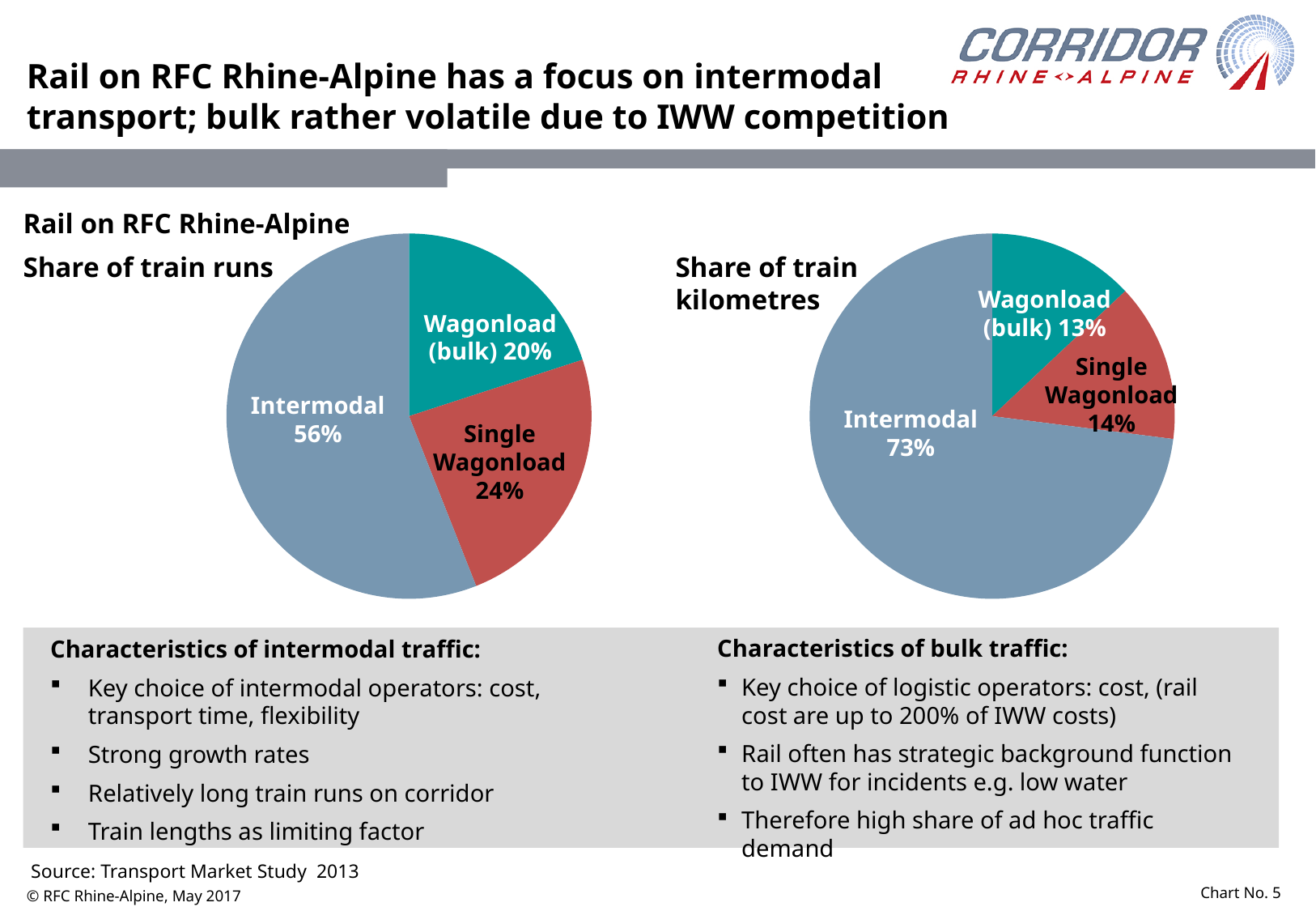
What is the difference between the Intermodal share in the 'Share of train kilometres' chart and the Intermodal share in the 'Share of train runs' chart? 17 percentage points How many slices does the 'Share of train runs' pie chart have? 3 In the 'Share of train kilometres' pie chart, which category has the smallest share? Wagonload (bulk) In the 'Share of train runs' pie chart, which category has the largest share? Intermodal In the 'Share of train runs' pie chart, what is the share for Wagonload (bulk)? 20% In the 'Share of train runs' pie chart, what is the share for Intermodal? 56% In the 'Share of train kilometres' pie chart, what is the share for Single Wagonload? 14% In the 'Share of train kilometres' pie chart, which is larger: Single Wagonload or Wagonload (bulk)? Single Wagonload In the 'Share of train runs' pie chart, what is the difference between the Single Wagonload share and the Wagonload (bulk) share? 4 percentage points In the 'Share of train kilometres' pie chart, what is the share for Intermodal? 73% What type of chart is the 'Share of train kilometres' chart? Pie chart In the 'Share of train runs' pie chart, what colour is the Intermodal slice? Grey-blue